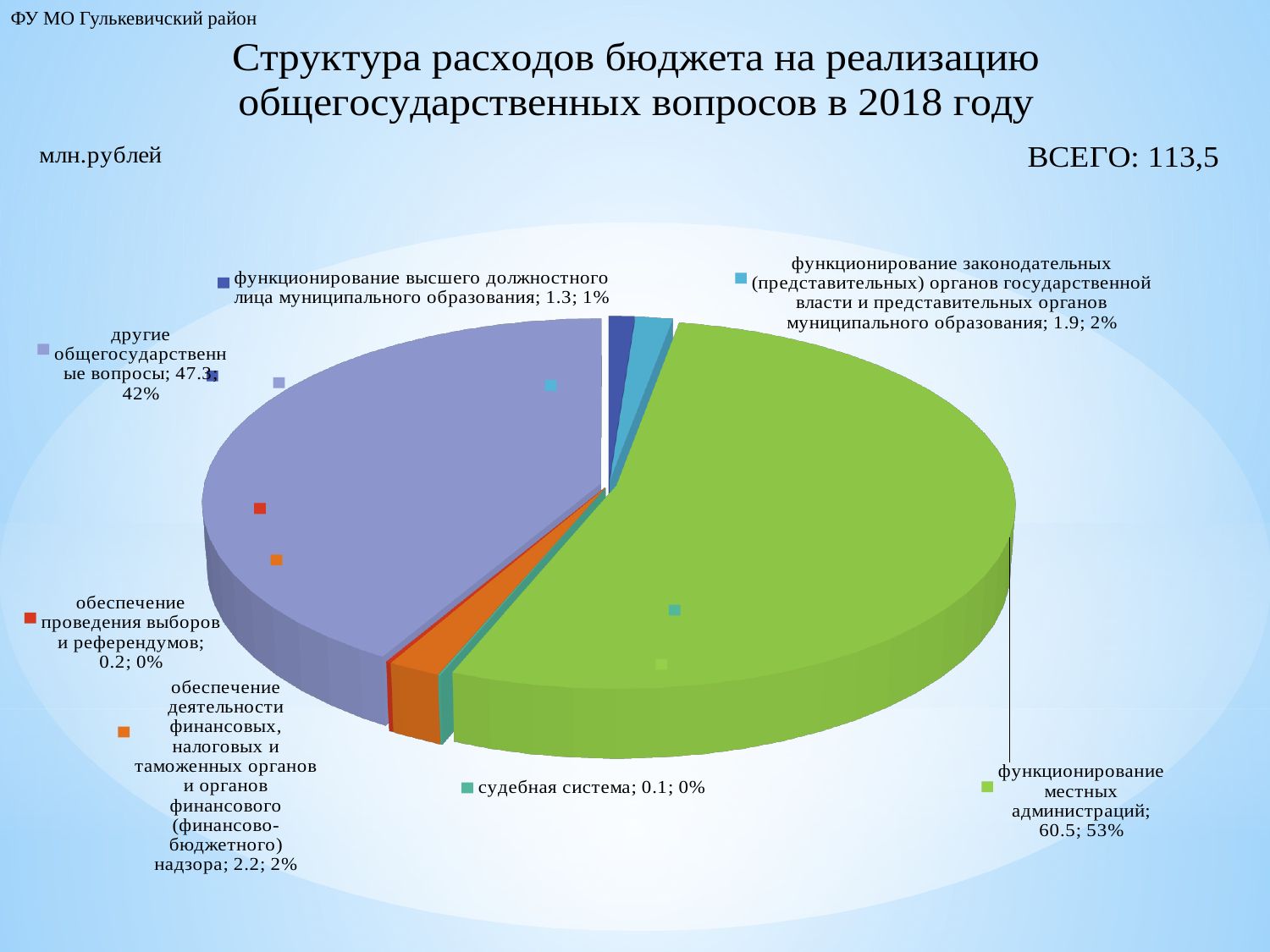
Какое значение (млн. рублей) указано для категории «функционирование высшего должностного лица муниципального образования»? 1.3 На сколько млн. рублей значение категории «функционирование местных администраций» больше значения категории «другие общегосударственные вопросы»? 13.2 Какую долю (в процентах) занимает категория «функционирование законодательных (представительных) органов государственной власти и представительных органов муниципального образования»? 2% Какое значение (млн. рублей) указано для категории «другие общегосударственные вопросы»? 47.3 Что больше: значение категории «обеспечение деятельности финансовых, налоговых и таможенных органов и органов финансового (финансово-бюджетного) надзора» или категории «функционирование законодательных (представительных) органов государственной власти и представительных органов муниципального образования»? обеспечение деятельности финансовых, налоговых и таможенных органов и органов финансового (финансово-бюджетного) надзора Какая категория имеет наибольшую долю на диаграмме? функционирование местных администраций Какой тип диаграммы показан на слайде? круговая диаграмма Сколько категорий (секторов) показано на круговой диаграмме? 7 Какую долю (в процентах) занимает категория «другие общегосударственные вопросы»? 42% Какая категория имеет наименьшее значение на диаграмме? судебная система Какое значение (млн. рублей) указано для категории «функционирование местных администраций»? 60.5 Какое значение (млн. рублей) указано для категории «судебная система»? 0.1